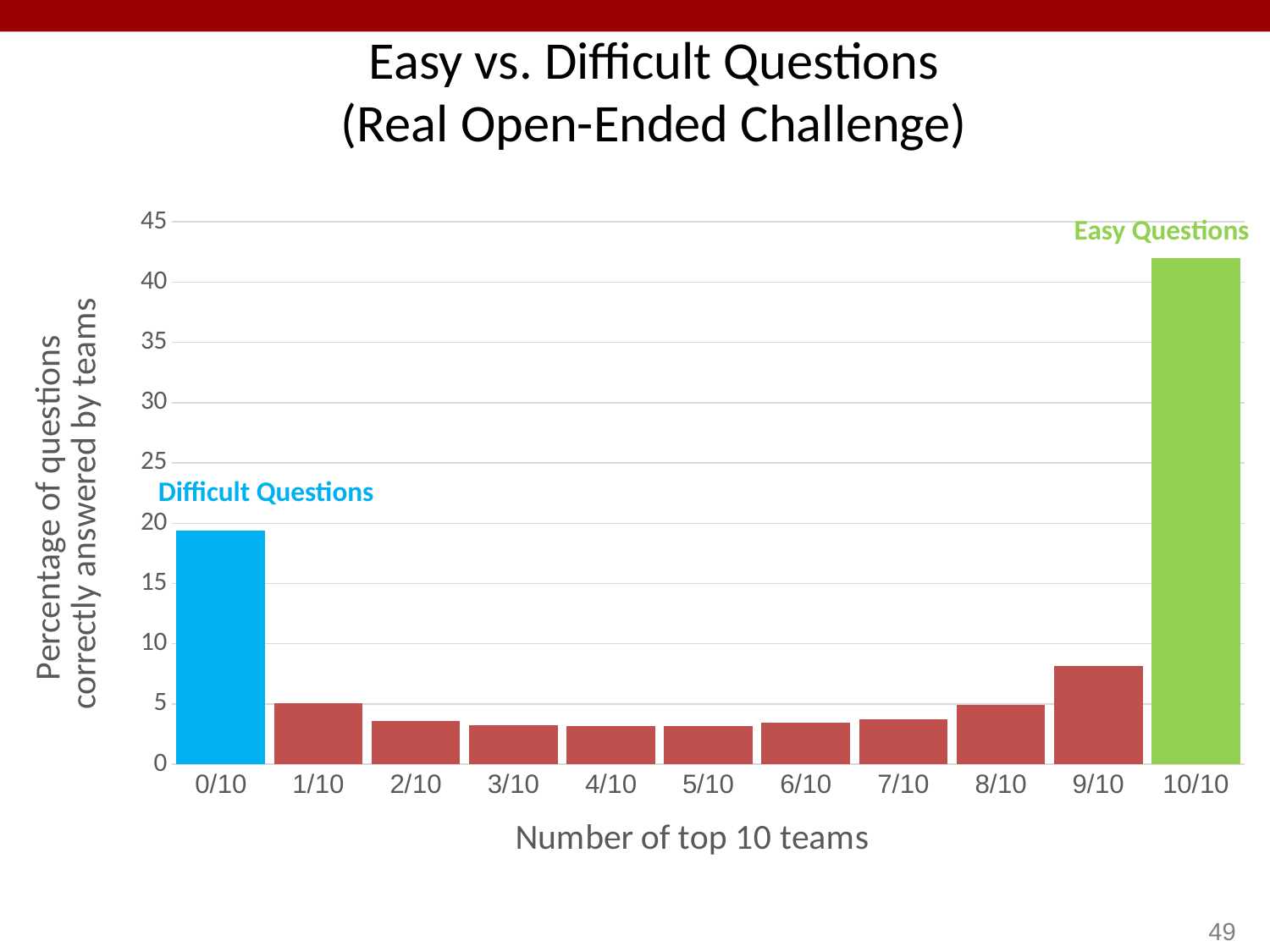
Is the value for 10/10 greater or less than 40? greater Which is larger, the value for 9/10 or the value for 1/10? 9/10 Which category's bar is labelled "Easy Questions"? 10/10 What is the label of the x axis? Number of top 10 teams Is the value for 9/10 greater or less than 5? greater Which category has the highest percentage of questions correctly answered? 10/10 Is the value for 9/10 greater or less than 10? less How many categories are shown along the x axis? 11 What kind of chart is shown on the slide? Bar chart Which is larger, the value for 0/10 or the value for 9/10? 0/10